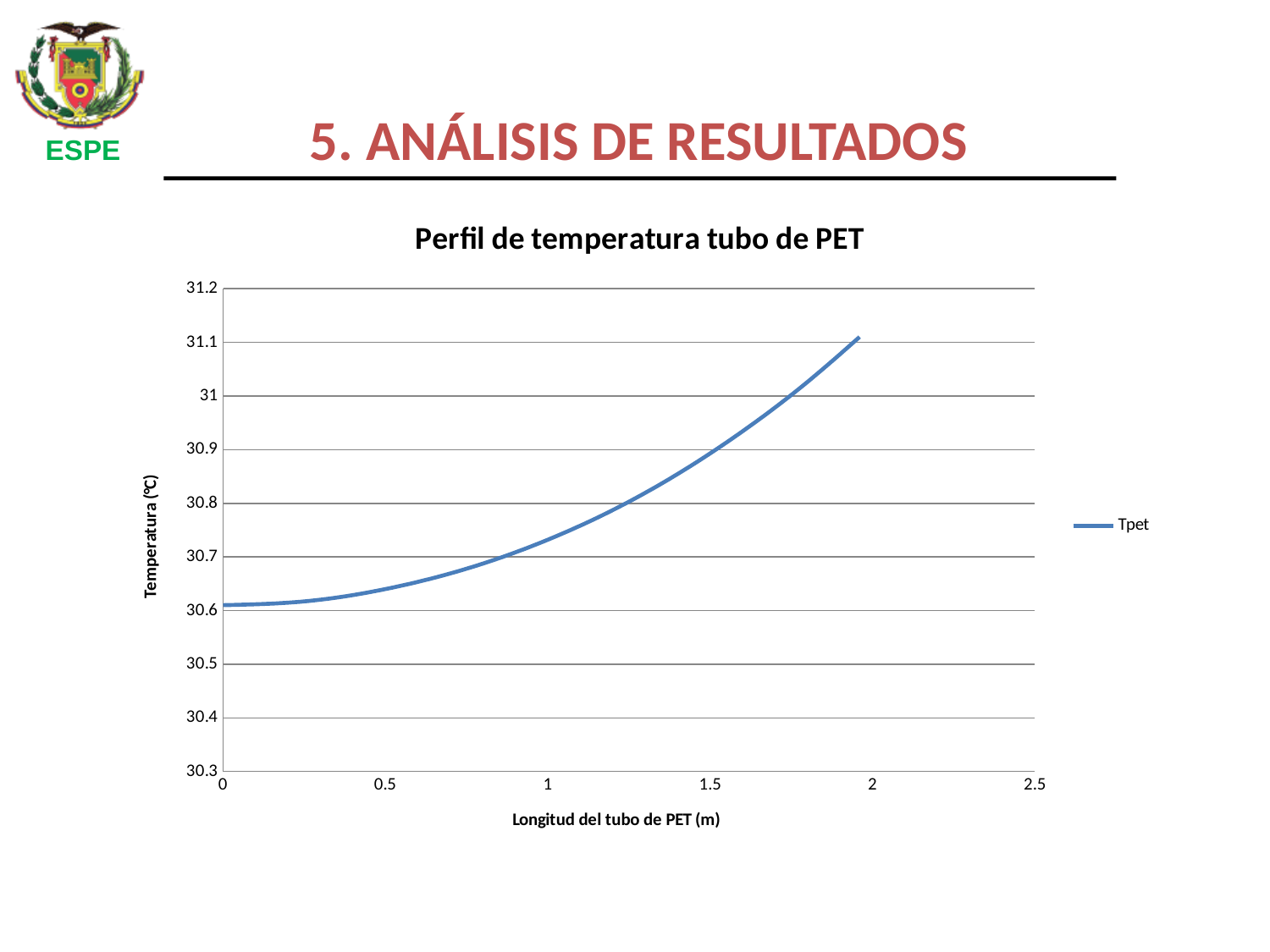
Is the Tpet value at a tube length of 1.5 m greater or less than 30.8? greater What is the title of the chart? Perfil de temperatura tubo de PET Is the Tpet value at a tube length of 0.5 m greater or less than 30.7? less What kind of chart is shown on the slide? line chart What is the name of the series shown in the legend? Tpet Is the Tpet value at a tube length of 0 m greater or less than 30.7? less Is the Tpet value at a tube length of 1.5 m larger or smaller than the value at 0.5 m? larger How many series does the legend list? 1 Does the temperature rise or fall as the length of the PET tube increases? rise